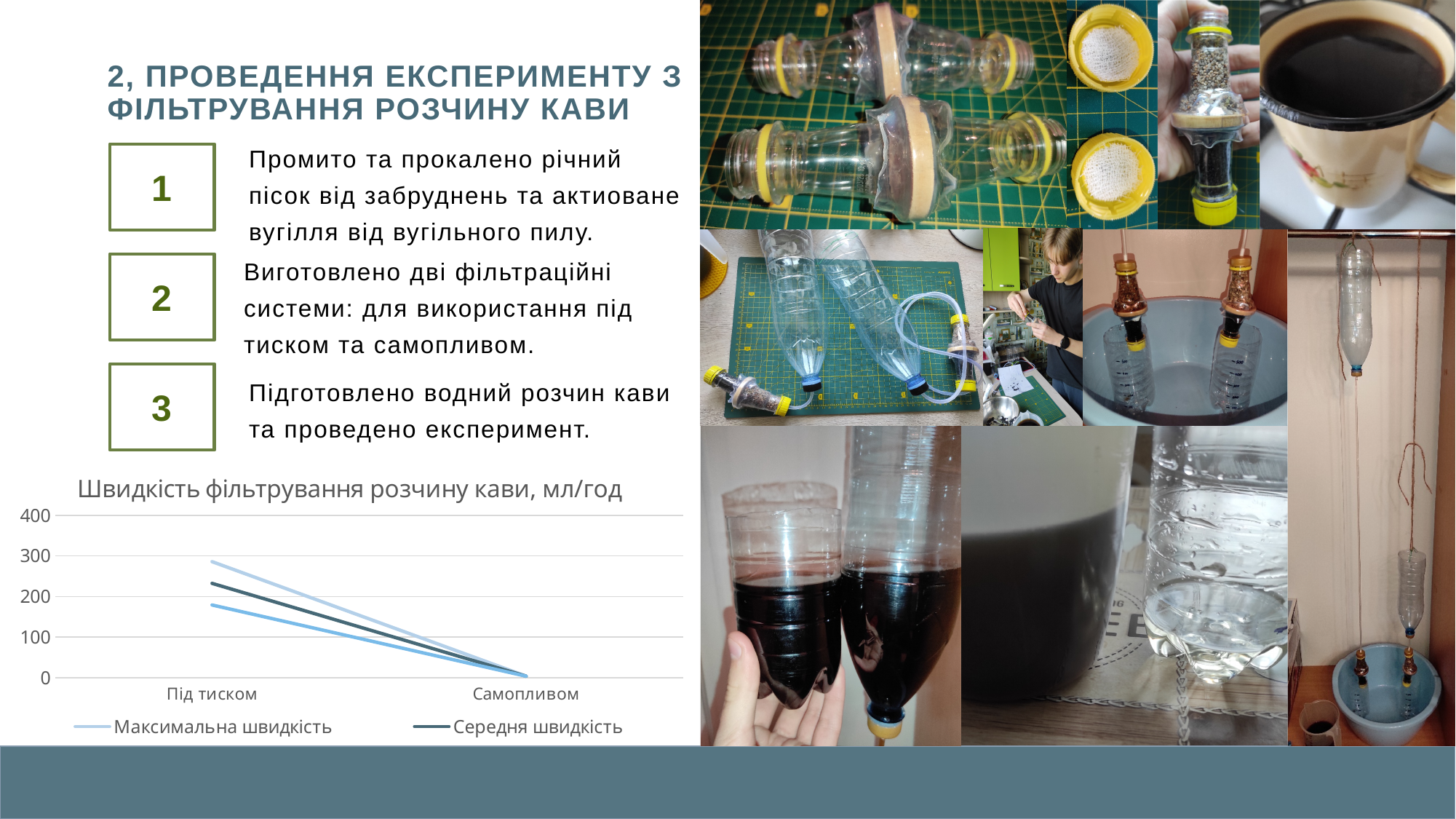
Is the value of Середня швидкість for Під тиском greater or less than 300? less Is the value of Максимальна швидкість for Під тиском greater or less than 200? greater How many categories are shown on the x axis of the chart? 2 Which series does the legend list first? Максимальна швидкість Is the value of Максимальна швидкість for Під тиском greater or less than 300? less Which category has the higher value for Максимальна швидкість, Під тиском or Самопливом? Під тиском What is the title of the chart on the slide? Швидкість фільтрування розчину кави, мл/год Do the values of Середня швидкість rise or fall from Під тиском to Самопливом? fall What kind of chart is shown on the slide? line chart How many series does the chart legend list? 2